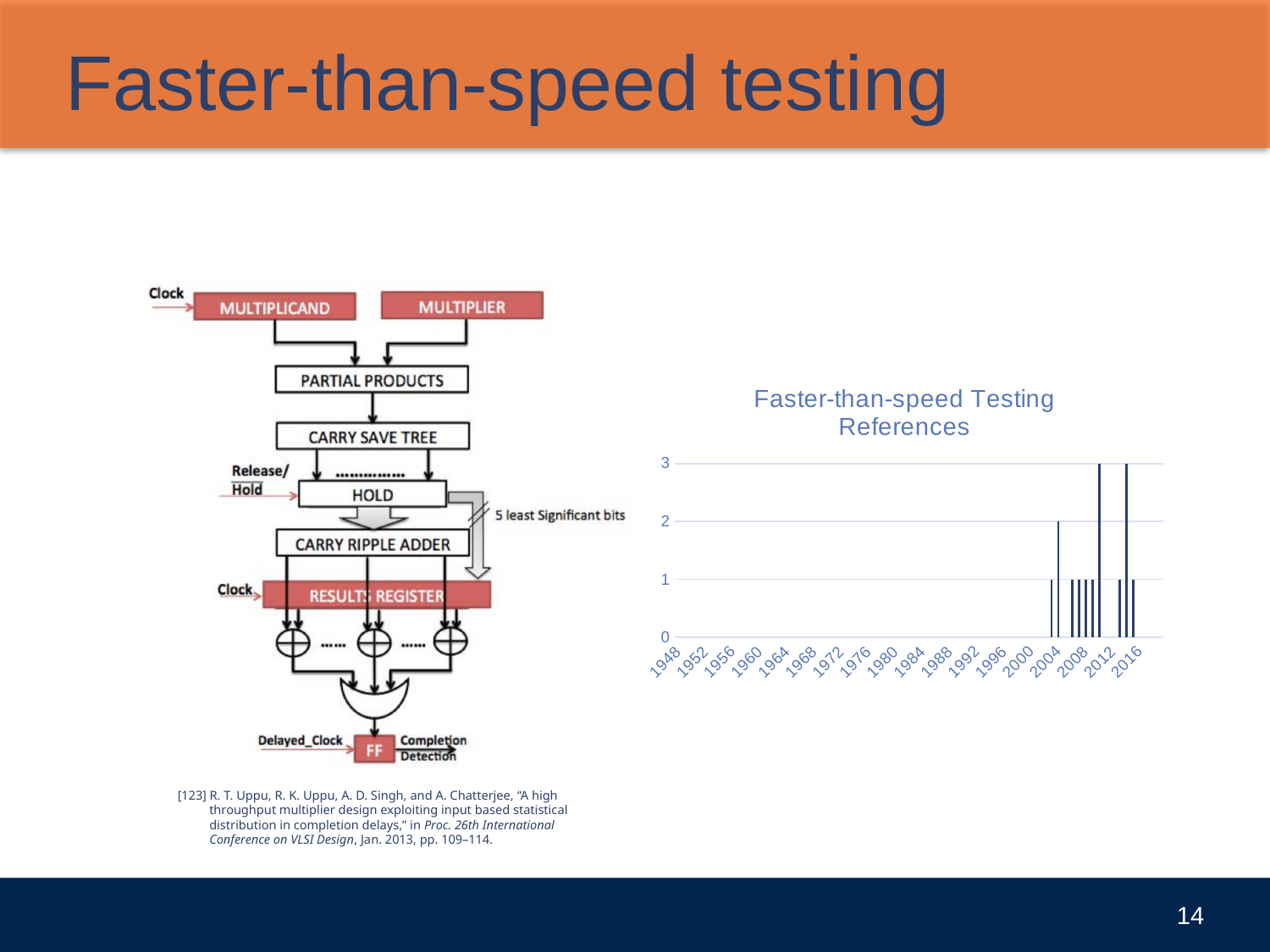
In the 'Faster-than-speed Testing References' chart, how many bars reach the value 3? 2 What kind of chart is the 'Faster-than-speed Testing References' chart? bar chart In the 'Faster-than-speed Testing References' chart, how many bars reach the value 2? 1 In the 'Faster-than-speed Testing References' chart, what is the highest value shown on the vertical axis? 3 In the 'Faster-than-speed Testing References' chart, what is the first year label on the horizontal axis? 1948 In the 'Faster-than-speed Testing References' chart, do the references appear mostly before or after 2004? after What is the title of the chart on the right side of the slide? Faster-than-speed Testing References In the 'Faster-than-speed Testing References' chart, are there any bars before the year 2000? No In the 'Faster-than-speed Testing References' chart, what is the highest value reached by any bar? 3